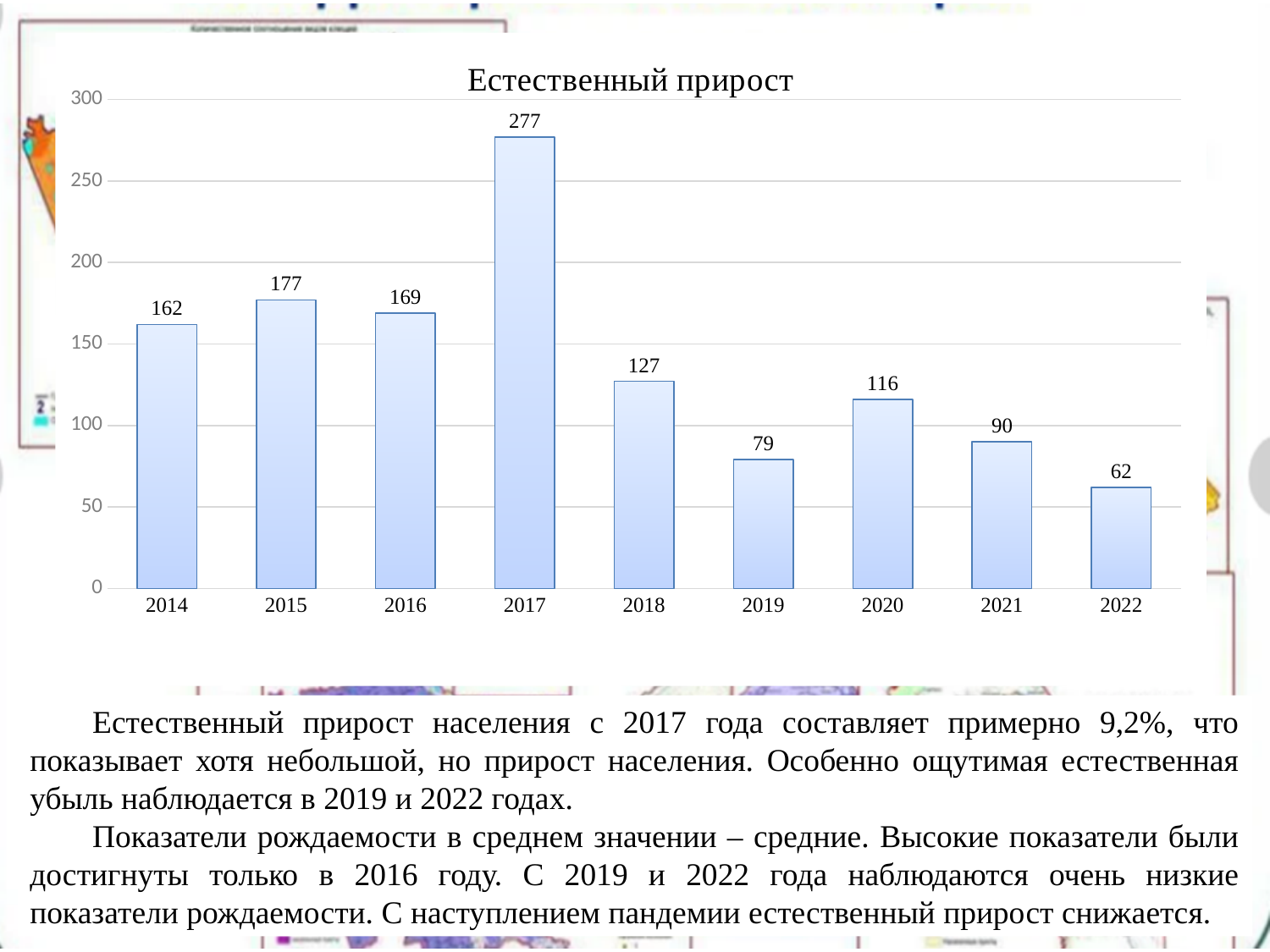
Which is larger, the value for 2020 or the value for 2021? 2020 What is the value for 2017? 277 How many years are shown on the x axis? 9 Which year has the lowest value? 2022 What is the value for 2022? 62 Is the value for 2016 greater or less than 150? greater What is the difference between the values for 2017 and 2018? 150 Which year has the highest value? 2017 What is the title of the chart? Естественный прирост What is the difference between the values for 2015 and 2014? 15 What is the value for 2019? 79 What kind of chart is this? bar chart